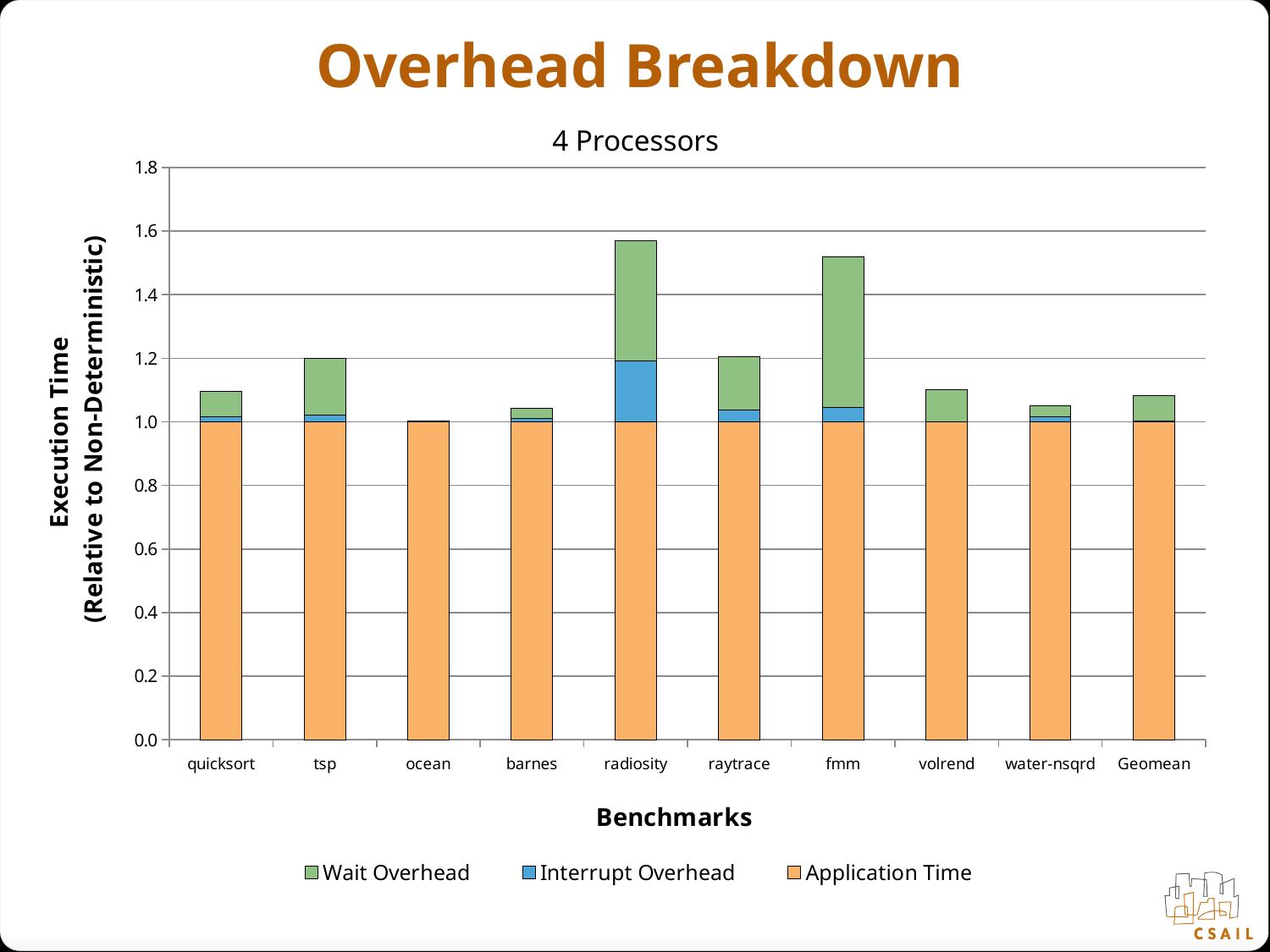
What is the Application Time value for ocean? 1.0 Which benchmark has the tallest stacked bar? radiosity Which benchmark has the shortest stacked bar? ocean Is the total bar height for volrend greater or less than 1.2? less What is the title shown above the chart's plot area? 4 Processors Which benchmark has the largest Interrupt Overhead segment? radiosity What kind of chart is shown on the slide? stacked bar chart Which has the larger Wait Overhead segment, fmm or radiosity? fmm How many series does the legend list? 3 How many benchmarks are shown along the x axis? 10 Is the total bar height for radiosity greater or less than 1.4? greater Is the total bar height for Geomean greater or less than 1.2? less